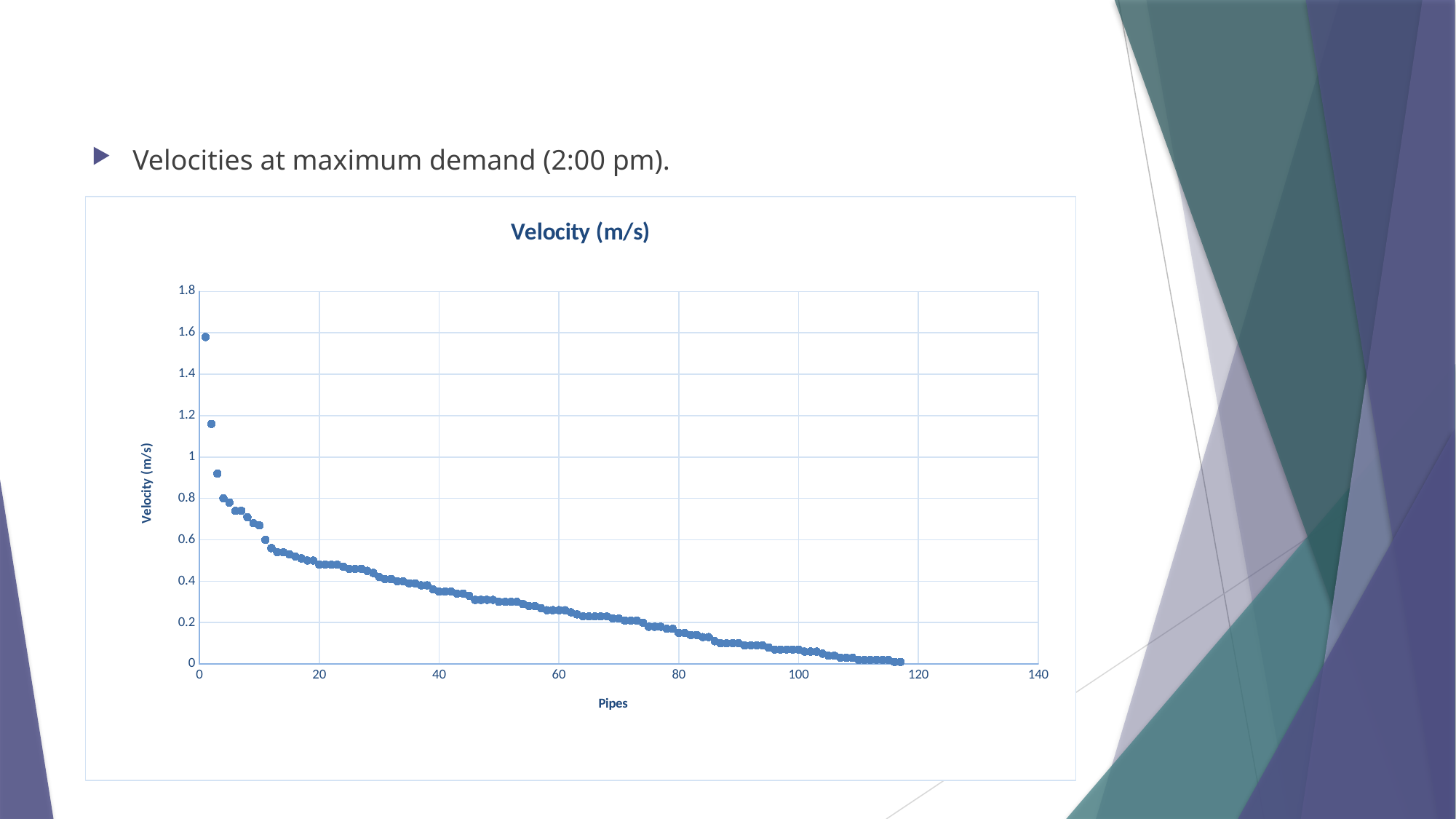
What is the label of the x axis of the chart? Pipes Is the velocity at pipe 40 greater or less than 0.2? greater Is the velocity at pipe 60 greater or less than 0.4? less Do the velocity values rise or fall as the pipe number increases along the x axis? Fall Which pipe has the highest velocity in the chart? Pipe 1 What is the title of the chart? Velocity (m/s) Is the velocity of the first point (pipe 1) greater or less than 1.4? greater What kind of chart is shown on the slide? Scatter chart What is the highest value shown on the y axis of the chart? 1.8 Which has the higher velocity, pipe 20 or pipe 80? Pipe 20